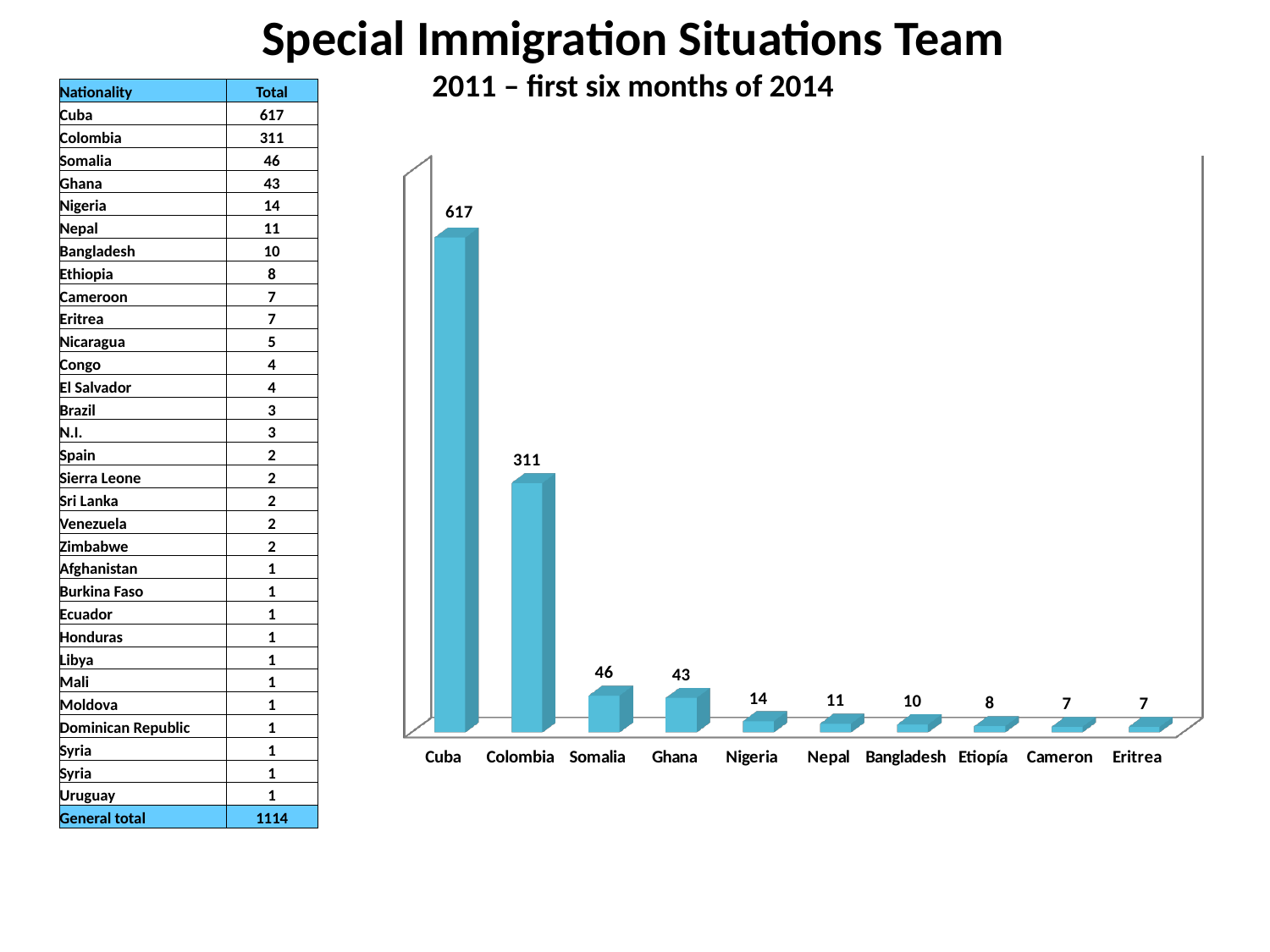
How many nationalities are shown as bars in the chart? 10 What is the difference between the values for Cuba and Colombia? 306 What value does the bar for Cuba show? 617 What is the difference between the values for Somalia and Ghana? 3 Which nationality has the highest bar in the chart? Cuba What value does the bar for Colombia show? 311 What kind of chart is shown on the slide? Bar chart Which is larger, the value for Nigeria or the value for Bangladesh? Nigeria What is the subtitle shown above the chart? 2011 – first six months of 2014 What value does the bar for Ghana show? 43 What value does the bar for Nepal show? 11 Do the bar values rise or fall from left to right across the chart? Fall